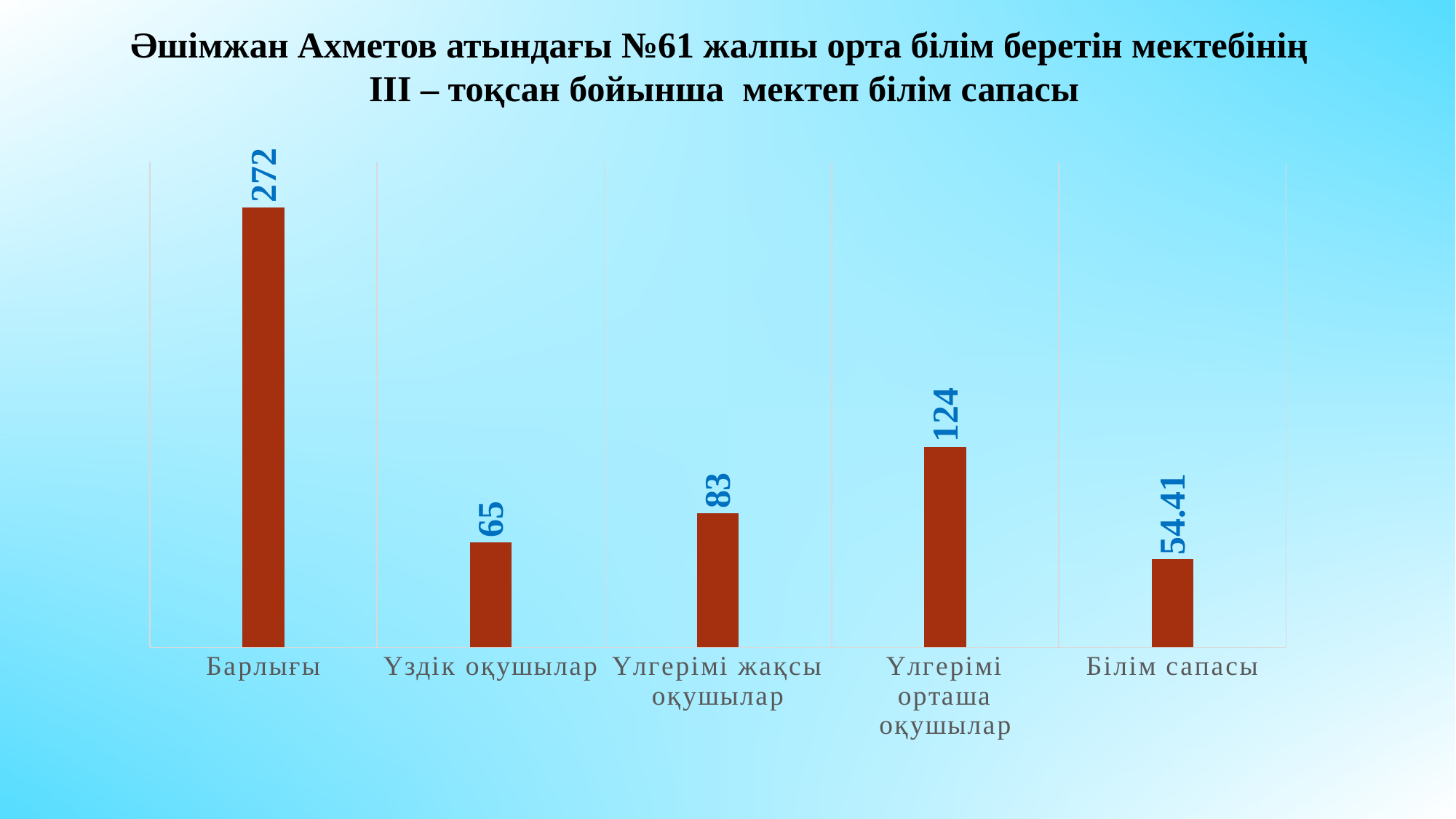
How many categories are shown in the chart? 5 What kind of chart is shown on the slide? bar chart Which is larger, the value for Үлгерімі орташа оқушылар or the value for Үлгерімі жақсы оқушылар? Үлгерімі орташа оқушылар What is the value for Барлығы? 272 Which category has the lowest value? Білім сапасы What is the difference between the values for Үлгерімі жақсы оқушылар and Үздік оқушылар? 18 What is the value for Үздік оқушылар? 65 What is the value for Білім сапасы? 54.41 Which category has the highest value? Барлығы What is the difference between the values for Барлығы and Үлгерімі орташа оқушылар? 148 What is the value for Үлгерімі жақсы оқушылар? 83 What is the value for Үлгерімі орташа оқушылар? 124